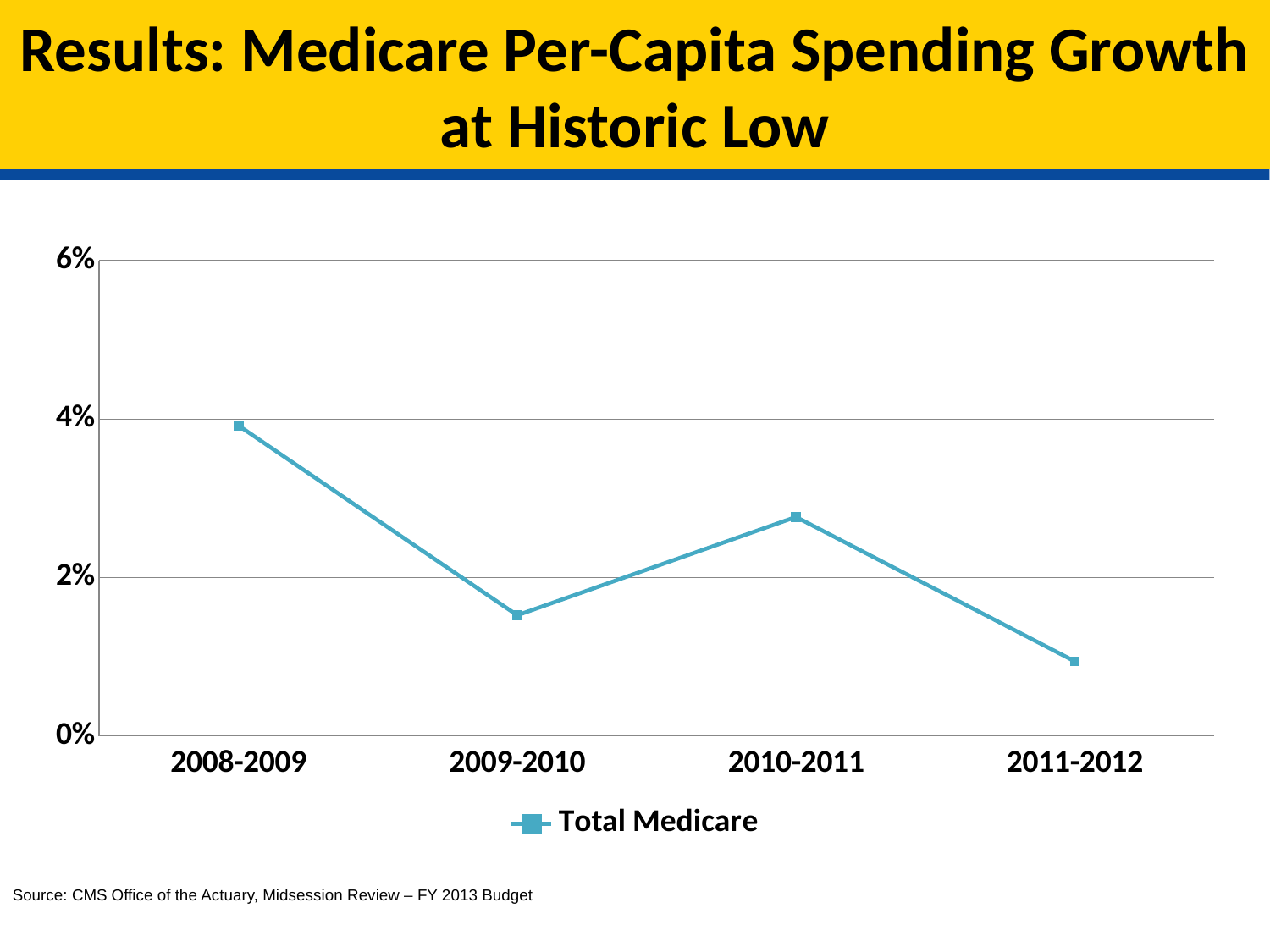
Is the value for 2011-2012 greater or less than 2%? less What kind of chart is shown on the slide? Line chart Which period has the highest Total Medicare per-capita spending growth? 2008-2009 What is the name of the series shown in the legend? Total Medicare How many periods are plotted along the x axis? 4 Which is larger, the value for 2010-2011 or the value for 2009-2010? 2010-2011 Is the value for 2010-2011 greater or less than 4%? less Is the value for 2009-2010 greater or less than 2%? less Overall, does the Total Medicare growth rate rise or fall from 2008-2009 to 2011-2012? Fall Which period has the lowest Total Medicare per-capita spending growth? 2011-2012 How many series does the legend list? 1